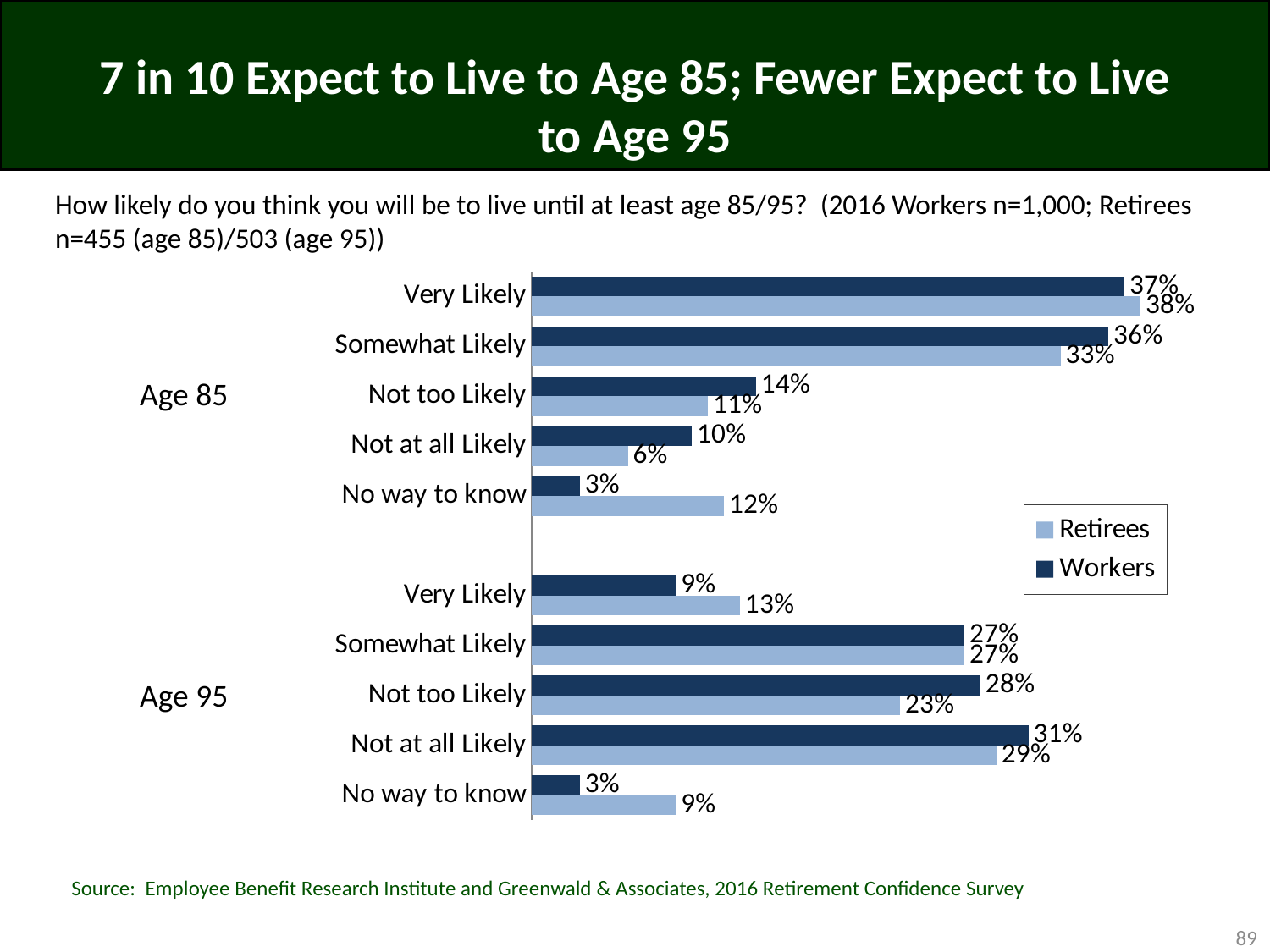
What percentage of Retirees say they are Not too Likely to live to Age 95? 23% What percentage of Workers say they are Very Likely to live to Age 85? 37% What percentage of Retirees say there is No way to know whether they will live to Age 85? 12% For Age 85, what is the difference between Workers and Retirees who say Not at all Likely? 4 percentage points For Age 95, what is the difference between Retirees and Workers who say Very Likely? 4 percentage points For Age 85, which group has the larger share saying Somewhat Likely, Workers or Retirees? Workers Which colour represents Retirees in the chart? Light blue For Age 85, which response category has the lowest value among Workers? No way to know For Age 95, which group has the larger share saying No way to know, Workers or Retirees? Retirees What kind of chart is shown on the slide? Bar chart How many series does the legend list? 2 For Age 95, which response category has the highest value among Workers? Not at all Likely